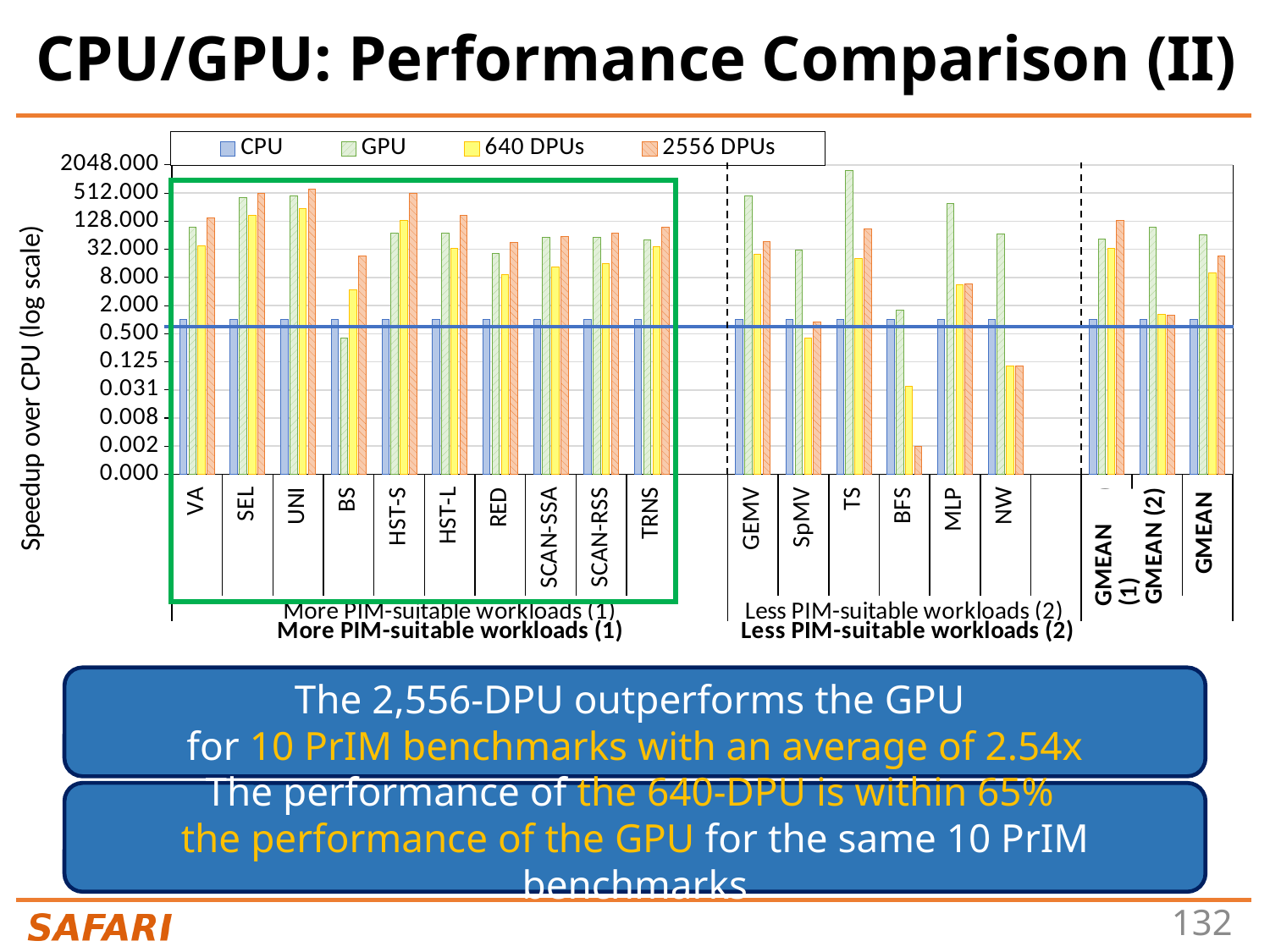
What is the label of the chart's y axis? Speedup over CPU (log scale) Which workload has the lowest 2556 DPUs bar? BFS What kind of chart is shown on the slide? bar chart How many workload categories are plotted in the 'More PIM-suitable workloads (1)' group? 10 For BS, which is larger: the GPU value or the 2556 DPUs value? 2556 DPUs Is the GPU value for TS greater or less than 512.000? greater Is the 2556 DPUs value for BFS greater or less than 0.008? less How many series does the chart legend list? 4 Which workload has the highest GPU bar? TS How many workload categories are plotted in the 'Less PIM-suitable workloads (2)' group? 6 For MLP, which is larger: the GPU value or the 2556 DPUs value? GPU What are the four series listed in the chart legend? CPU, GPU, 640 DPUs, 2556 DPUs